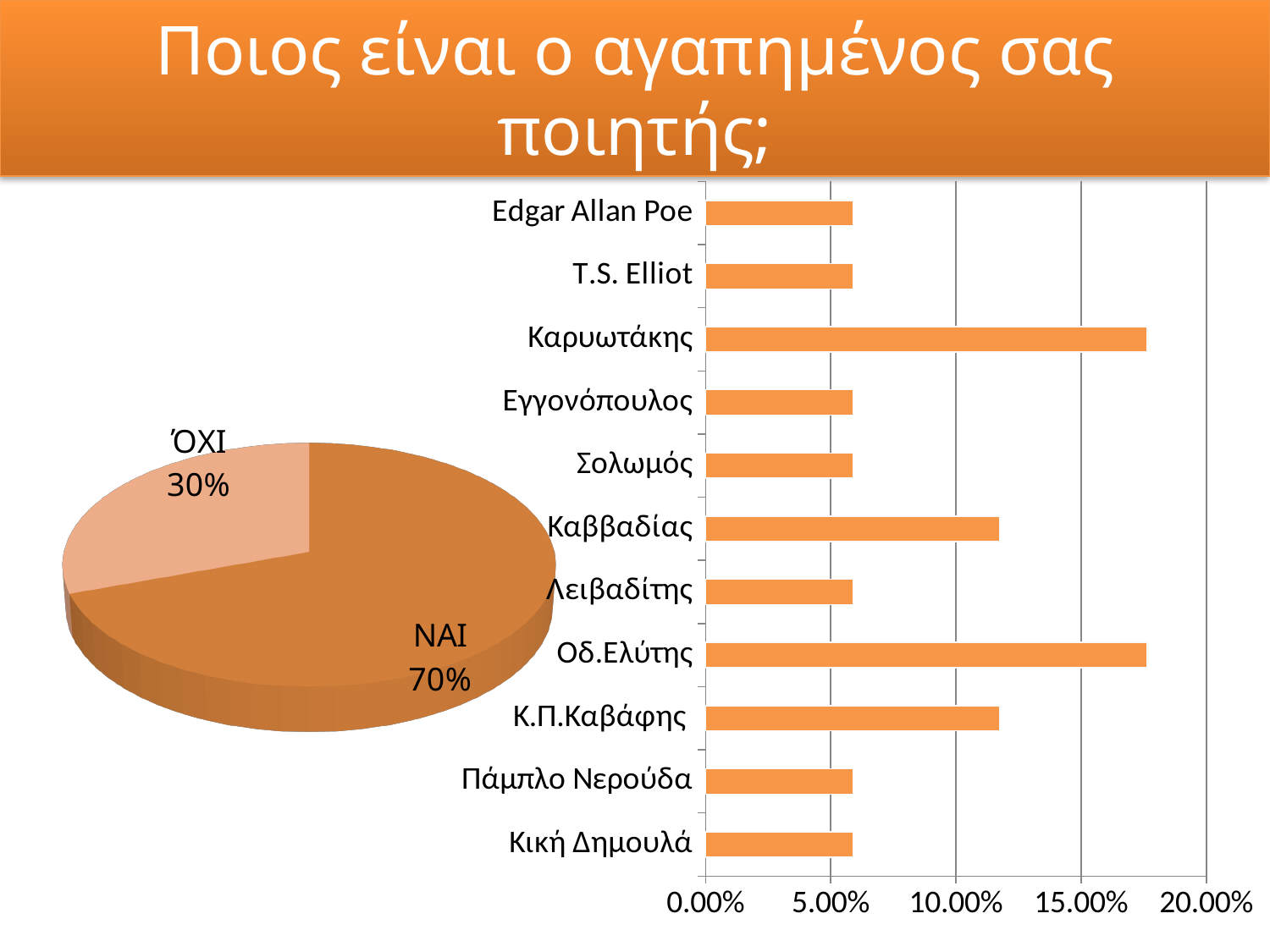
In the pie chart on the left, what share is labelled ΌΧΙ? 30% In the bar chart on the right, is the value for Σολωμός greater or less than 10.00%? less In the bar chart on the right, which has the larger value, Οδ.Ελύτης or Κ.Π.Καβάφης? Οδ.Ελύτης In the pie chart on the left, how many slices are there? 2 In the pie chart on the left, what share is labelled ΝΑΙ? 70% In the bar chart on the right, is the value for Καρυωτάκης greater or less than 15.00%? greater In the bar chart on the right, is the value for Καββαδίας greater or less than 10.00%? greater What kind of chart is the chart on the left of the slide? Pie chart What kind of chart is the chart on the right of the slide? Bar chart In the pie chart on the left, which slice is larger, ΝΑΙ or ΌΧΙ? ΝΑΙ In the pie chart on the left, how many percentage points larger is ΝΑΙ than ΌΧΙ? 40 In the bar chart on the right, how many poets are listed? 11